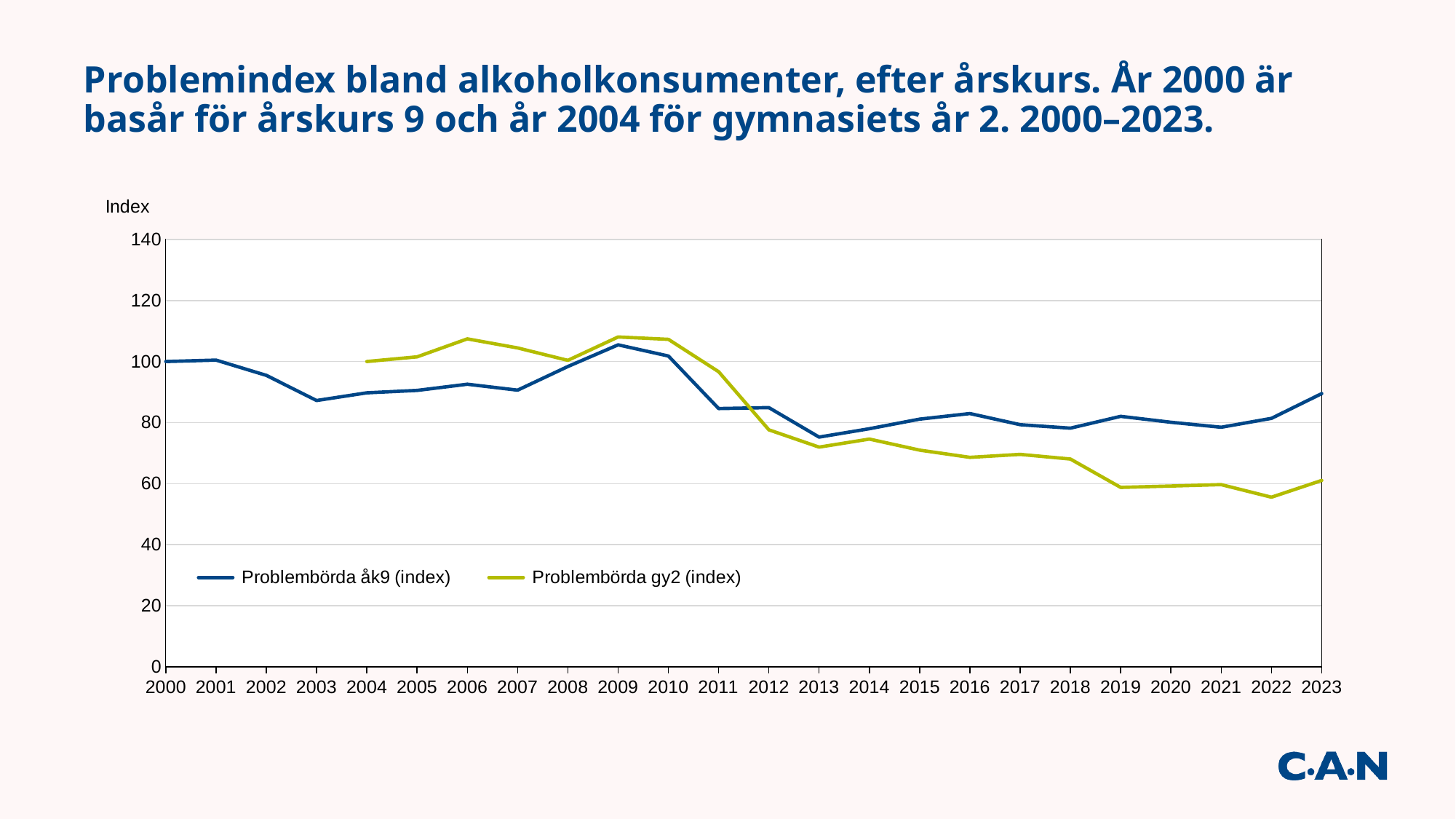
What is the value of Problembörda åk9 (index) in 2000? 100 In 2011, which series has the higher value, Problembörda åk9 (index) or Problembörda gy2 (index)? Problembörda gy2 (index) How many series does the legend list? 2 Is the value for Problembörda gy2 (index) in 2006 greater or less than 100? greater Is the value for Problembörda gy2 (index) in 2022 greater or less than 60? less Does Problembörda gy2 (index) rise or fall between 2010 and 2013? fall In which year does Problembörda åk9 (index) reach its highest value? 2009 In 2019, which series has the higher value, Problembörda åk9 (index) or Problembörda gy2 (index)? Problembörda åk9 (index) In which year does Problembörda gy2 (index) reach its lowest value? 2022 Is the value for Problembörda åk9 (index) in 2013 greater or less than 80? less What is the value of Problembörda gy2 (index) in 2004? 100 What kind of chart is shown on the slide? line chart